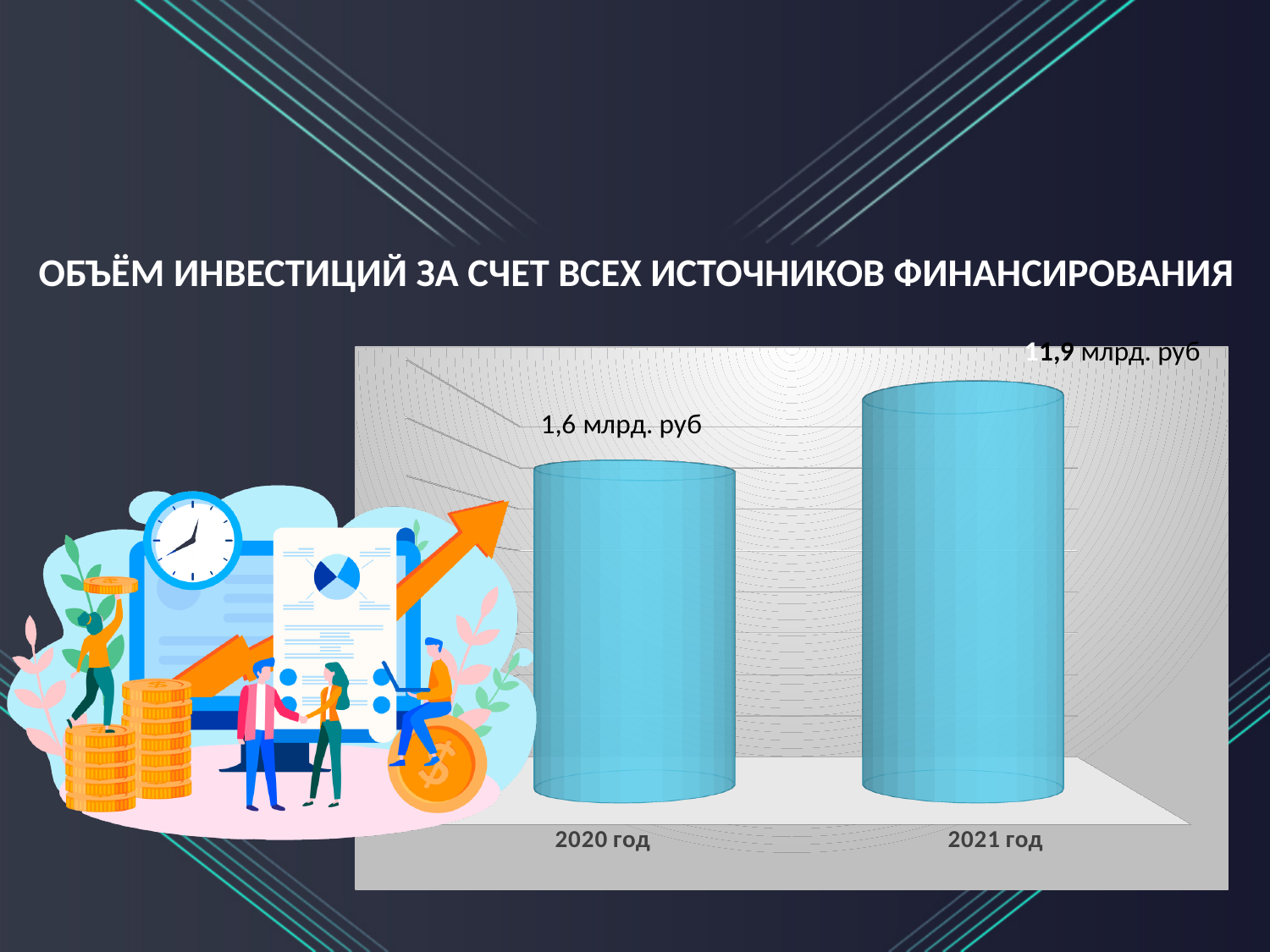
What is the title of the slide above the chart? ОБЪЁМ ИНВЕСТИЦИЙ ЗА СЧЕТ ВСЕХ ИСТОЧНИКОВ ФИНАНСИРОВАНИЯ Which year has the higher investment volume? 2021 год How many categories (years) are plotted on the chart? 2 Is the value for 2021 год larger or smaller than the value for 2020 год? larger What is the value shown for 2020 год? 1,6 млрд. руб By how much does the value for 2021 год exceed the value for 2020 год? 0,3 млрд. руб What is the value shown for 2021 год? 1,9 млрд. руб Which year has the lower investment volume? 2020 год What colour are the bars in the chart? light blue Do the values rise or fall from 2020 год to 2021 год? rise What kind of chart is shown on the slide? bar chart